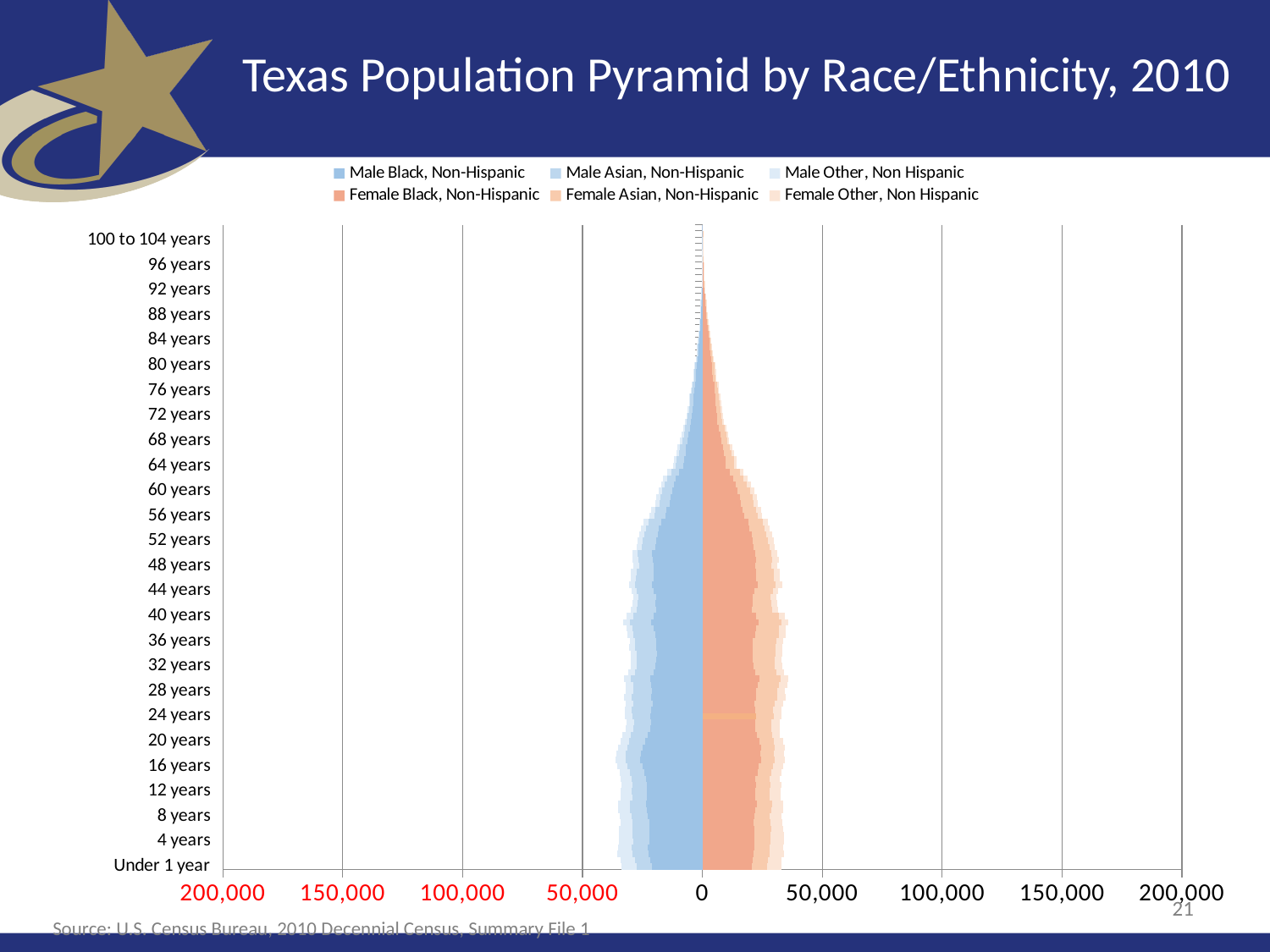
What is the title of the chart? Texas Population Pyramid by Race/Ethnicity, 2010 Is the total male population at 40 years greater or less than 50,000? less Which age has the larger total female population, 40 years or 80 years? 40 years What kind of chart is shown on the slide? Bar chart (population pyramid) Do the bar lengths rise or fall as age increases from 60 years to 100 to 104 years? Fall Which age label is at the bottom of the vertical axis? Under 1 year How many age labels are shown on the vertical axis? 26 Is the total male population at 16 years greater or less than 100,000? less How many series does the legend list? 6 What is the largest value labelled on the horizontal axis? 200,000 Is the total female population at 80 years greater or less than 50,000? less Which side of the chart shows the male series, left or right? Left